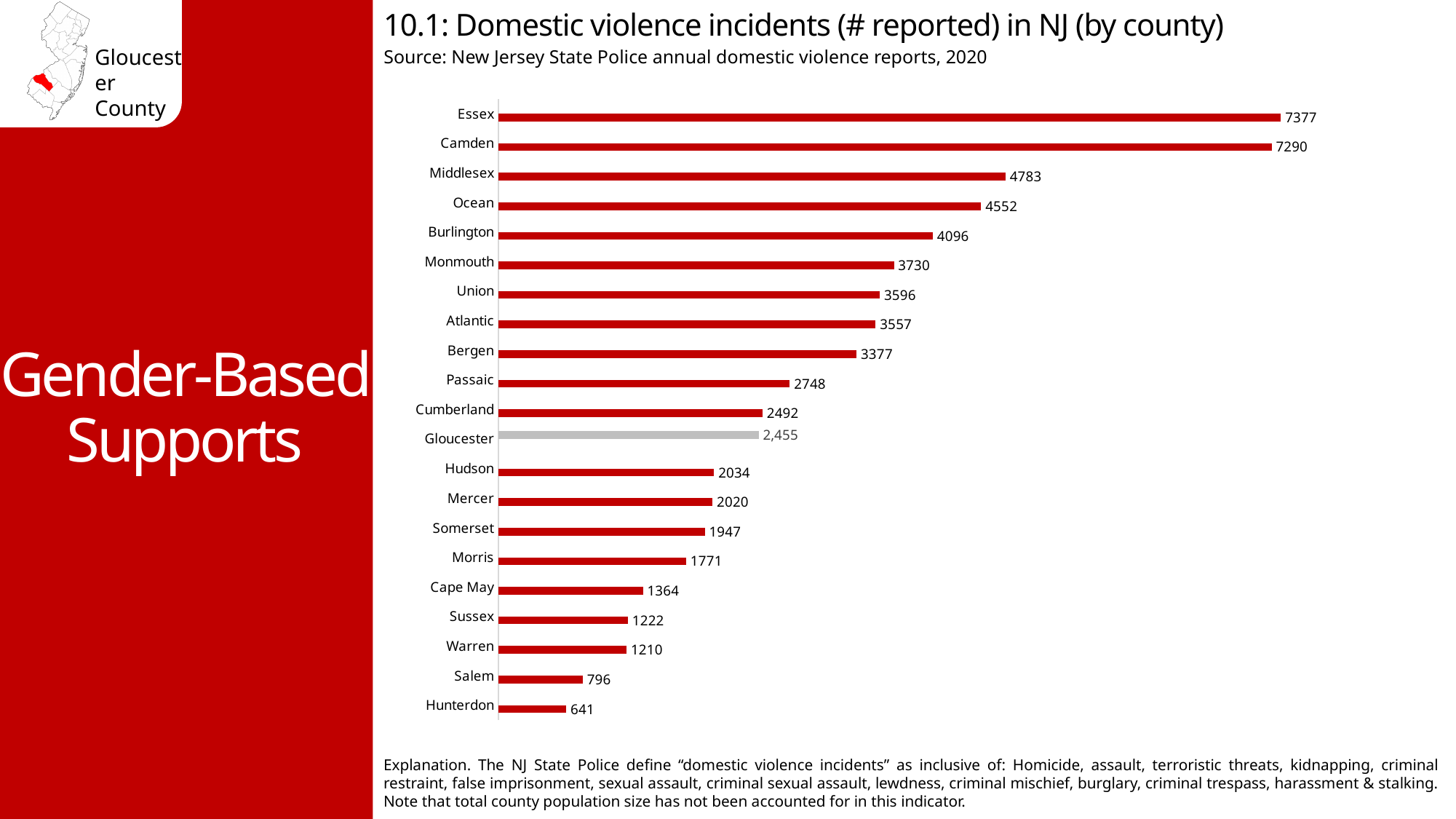
How many counties are shown in the chart? 21 Which county has the highest number of reported domestic violence incidents? Essex What kind of chart is shown on the slide? Bar chart What is the difference between the values for Cumberland and Gloucester? 37 What is the number of reported domestic violence incidents for Gloucester County? 2,455 What is the value shown for Morris? 1771 Which has fewer reported incidents, Salem or Hunterdon? Hunterdon Which county's bar is shown in grey rather than red? Gloucester Which county has the lowest number of reported domestic violence incidents? Hunterdon What is the number of reported domestic violence incidents for Camden? 7290 Which has more reported incidents, Middlesex or Ocean? Middlesex What is the difference between the values for Essex and Camden? 87